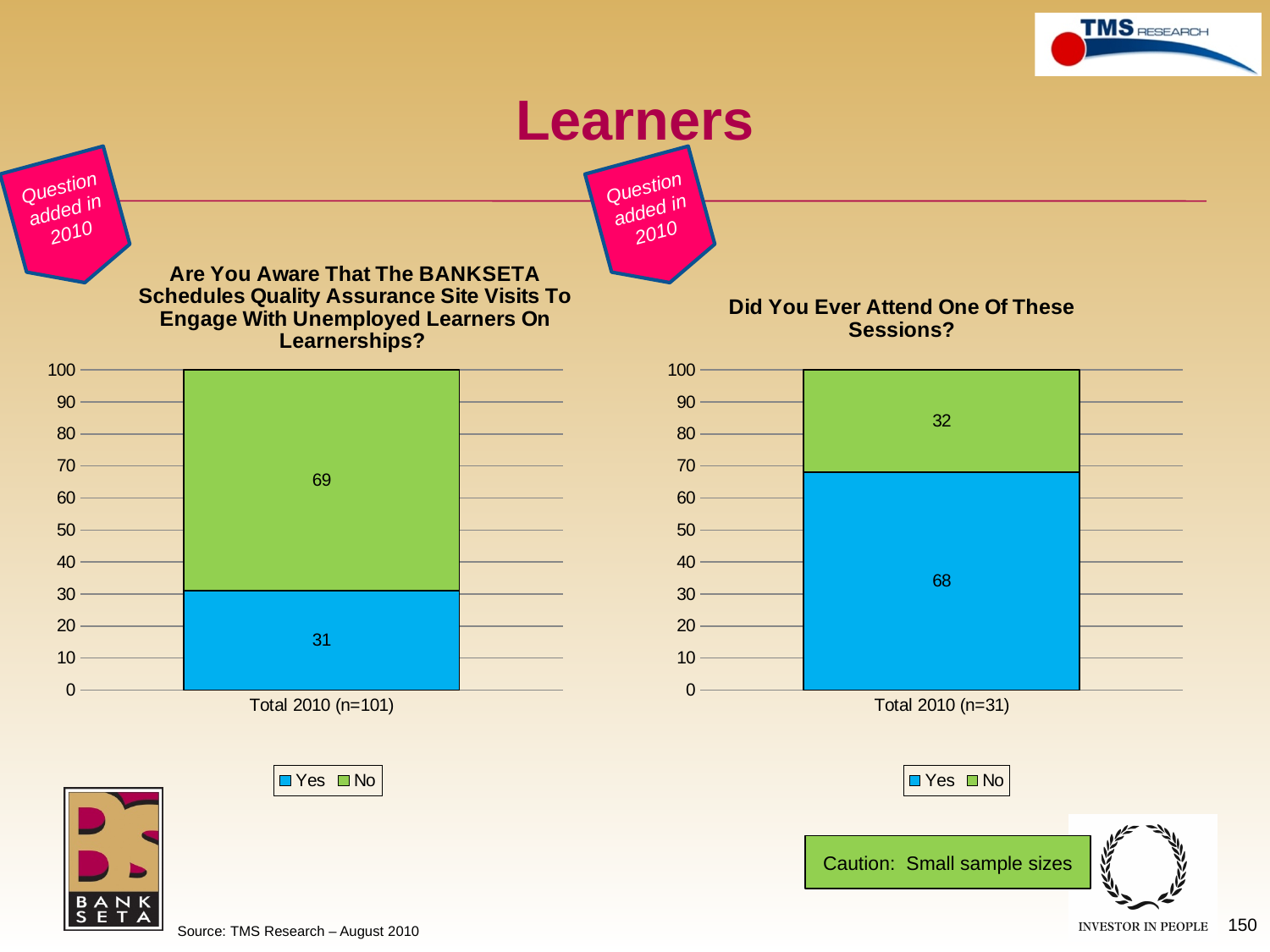
In the left chart ('Are You Aware That The BANKSETA Schedules Quality Assurance Site Visits...'), what is the difference between the No and Yes values? 38 In the right chart ('Did You Ever Attend One Of These Sessions?'), what is the value for No? 32 In the right chart ('Did You Ever Attend One Of These Sessions?'), what is the total of the stacked bar? 100 In the right chart ('Did You Ever Attend One Of These Sessions?'), what is the difference between the Yes and No values? 36 In the right chart ('Did You Ever Attend One Of These Sessions?'), what is the value for Yes? 68 In the left chart ('Are You Aware That The BANKSETA Schedules Quality Assurance Site Visits...'), which is larger, Yes or No? No In the right chart ('Did You Ever Attend One Of These Sessions?'), which is larger, Yes or No? Yes In the left chart ('Are You Aware That The BANKSETA Schedules Quality Assurance Site Visits...'), what is the value for Yes? 31 What kind of chart is the right chart ('Did You Ever Attend One Of These Sessions?')? Stacked bar chart What is the x-axis category label of the right chart ('Did You Ever Attend One Of These Sessions?')? Total 2010 (n=31) In the left chart ('Are You Aware That The BANKSETA Schedules Quality Assurance Site Visits...'), what is the value for No? 69 How many series does the legend of the left chart list? 2